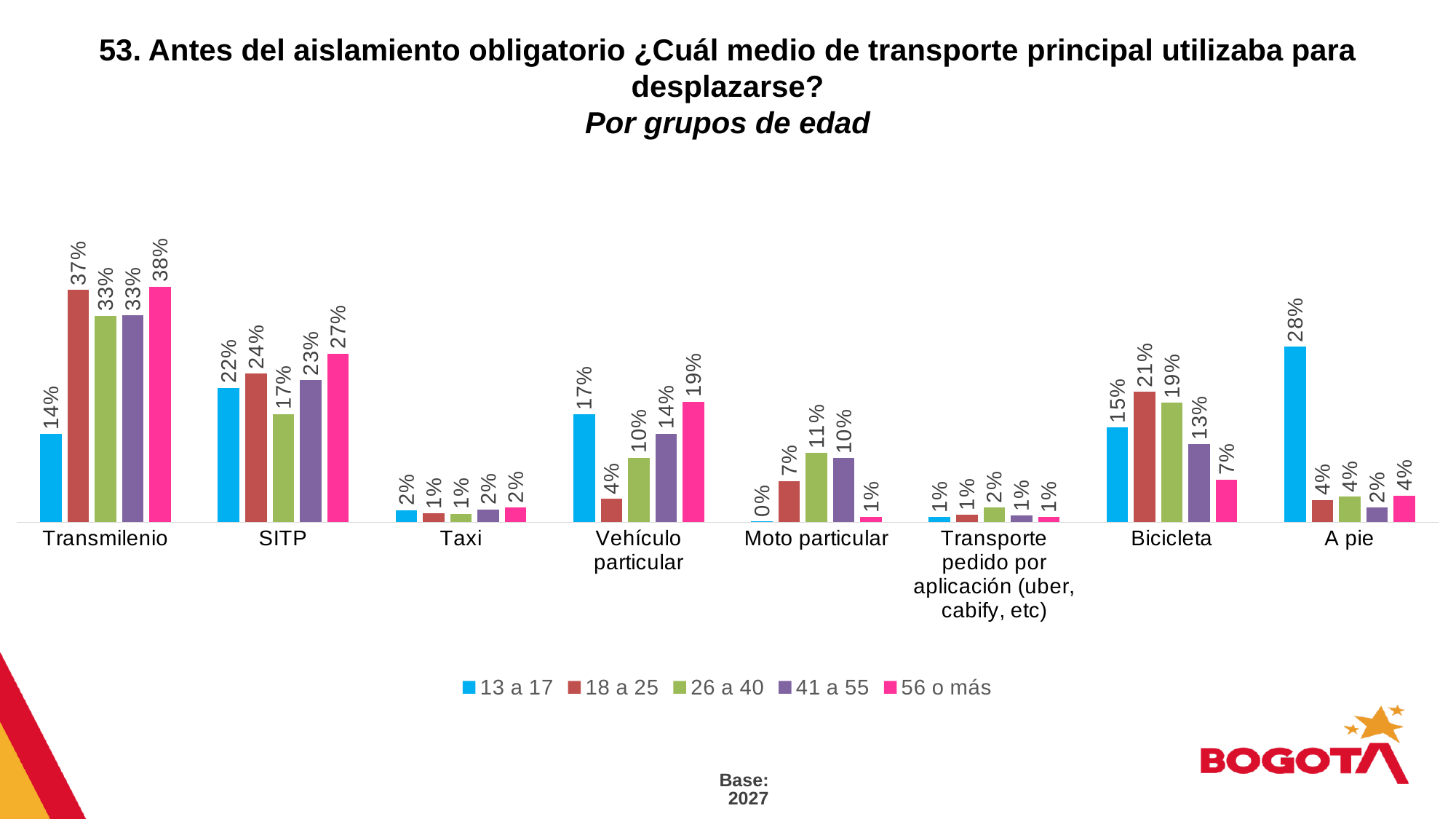
How many series does the legend list? 5 Which is larger for SITP: the value for 18 a 25 or the value for 41 a 55? 18 a 25 What is the value for the 56 o más group for Transmilenio? 38% What is the base (number of respondents) shown below the chart? 2027 What kind of chart is shown on the slide? Bar chart Which age group has the lowest value for Moto particular? 13 a 17 How many transport categories are shown on the x axis? 8 What is the difference between the 56 o más and 13 a 17 values for Vehículo particular? 2% What is the value for the 41 a 55 group for Bicicleta? 13% What is the value for the 26 a 40 group for SITP? 17% Which age group has the highest value for Transmilenio? 56 o más What is the value for the 13 a 17 group for A pie? 28%